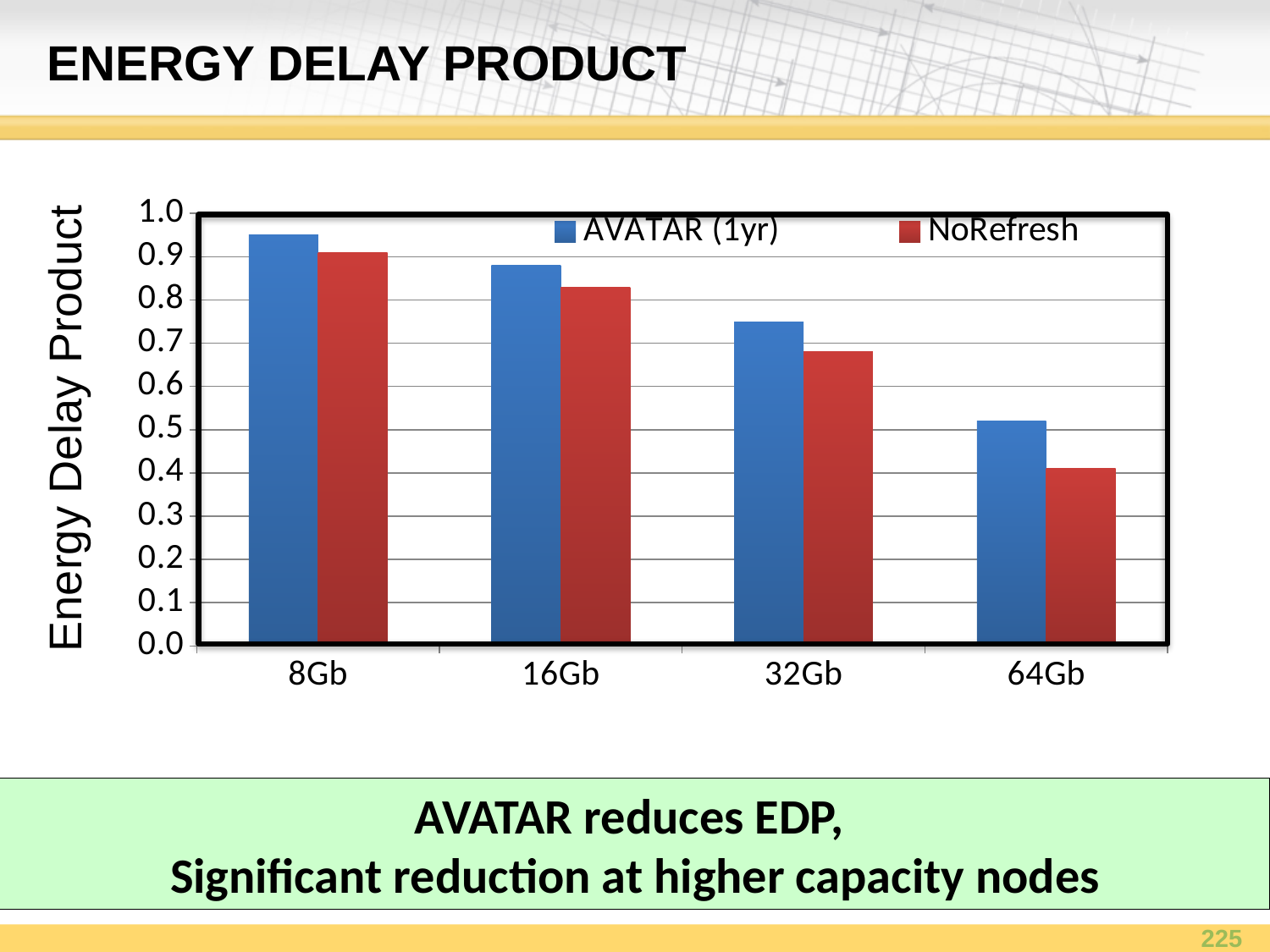
How many capacity categories are shown on the x axis? 4 At which capacity is the NoRefresh value lowest? 64Gb Is the AVATAR (1yr) value for 32Gb greater or less than 0.7? greater What is the label on the vertical axis? Energy Delay Product Is the AVATAR (1yr) value for 8Gb greater or less than 0.9? greater Do the AVATAR (1yr) values rise or fall as capacity increases from 8Gb to 64Gb? fall Is the NoRefresh value for 64Gb greater or less than 0.5? less Which series is shown in red? NoRefresh What kind of chart is shown on the slide? bar chart At 64Gb, which series has the larger value, AVATAR (1yr) or NoRefresh? AVATAR (1yr) How many series does the legend list? 2 At which capacity is the AVATAR (1yr) value highest? 8Gb